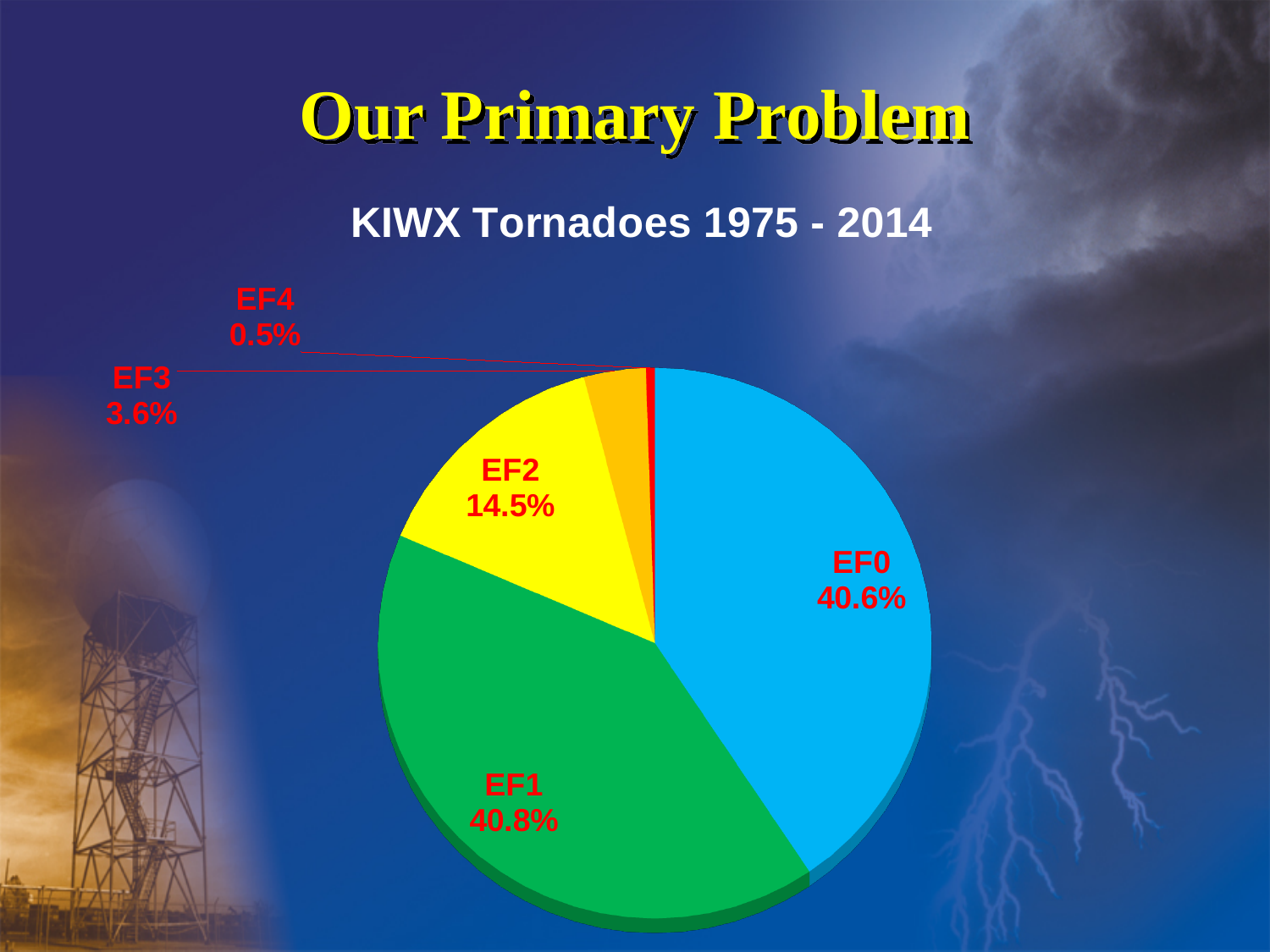
What share of tornadoes does the EF3 slice represent? 3.6% What is the difference in percentage points between the EF2 and EF3 shares? 10.9 How many percentage points larger is the EF0 share than the EF2 share? 26.1 Which tornado rating has the largest share according to the printed labels? EF1 Which slice is larger, EF2 or EF3? EF2 What is the value shown for EF4? 0.5% How many slices does the pie chart have? 5 What percentage of the pie is the EF2 slice? 14.5% What is the title of the chart? KIWX Tornadoes 1975 - 2014 Which tornado rating has the smallest slice of the pie? EF4 What percentage of KIWX tornadoes from 1975 - 2014 were rated EF0? 40.6% What type of chart is shown on the slide? Pie chart